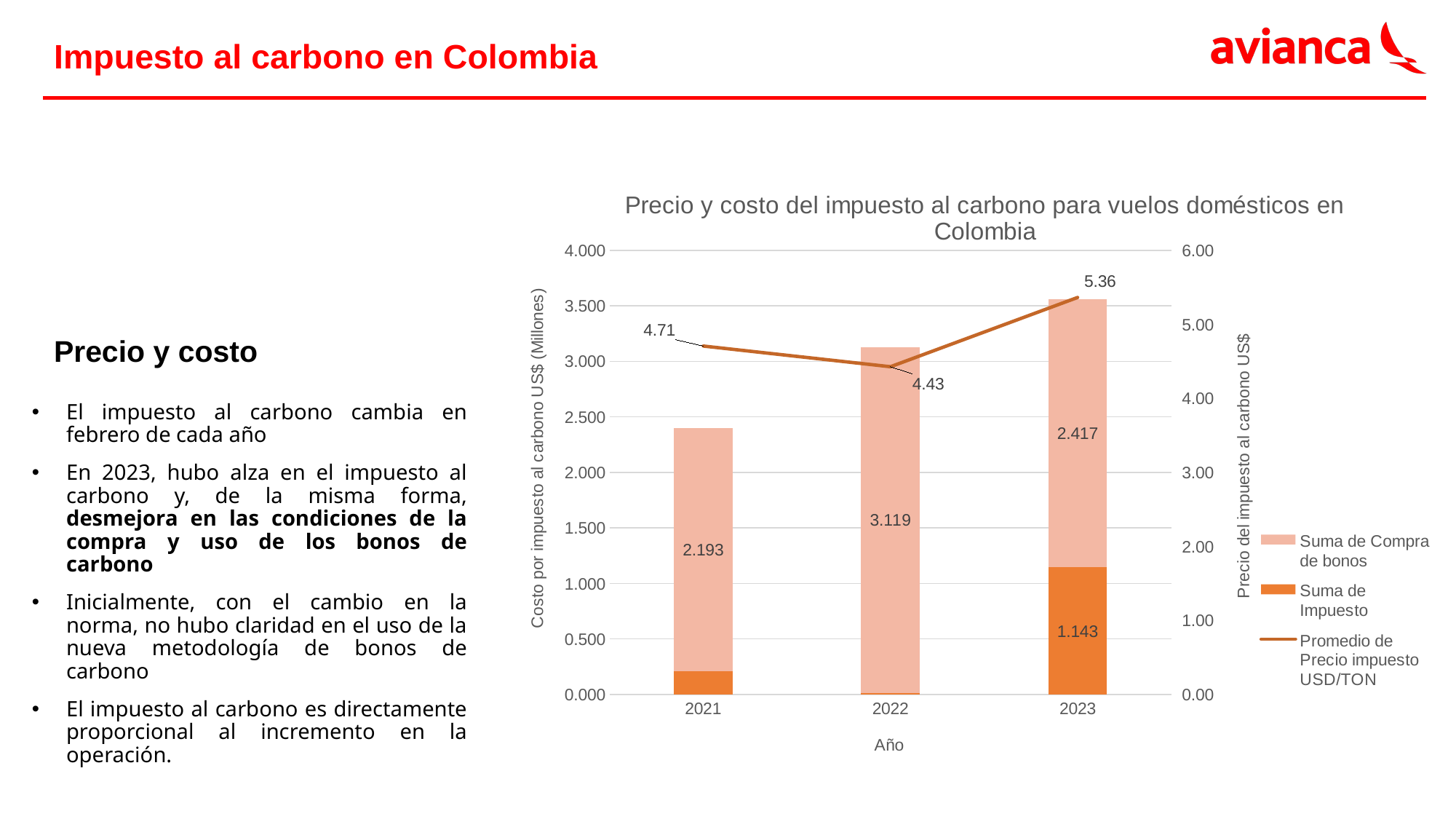
What is the value of Suma de Impuesto for 2023? 1.143 Which is larger: Suma de Compra de bonos in 2022 or in 2023? 2022 Does the Promedio de Precio impuesto USD/TON line rise or fall from 2022 to 2023? rise What is the difference between the Promedio de Precio impuesto USD/TON in 2023 and in 2022? 0.93 How many series does the legend list? 3 What is the total of the stacked bar for 2023? 3.560 Which year has the highest Promedio de Precio impuesto USD/TON? 2023 What is the Promedio de Precio impuesto USD/TON for 2021? 4.71 Is the value of Suma de Impuesto for 2021 greater or less than 0.500? less Which year has the lowest value for Suma de Compra de bonos? 2021 How many years are shown on the x axis? 3 What is the value of Suma de Compra de bonos for 2022? 3.119